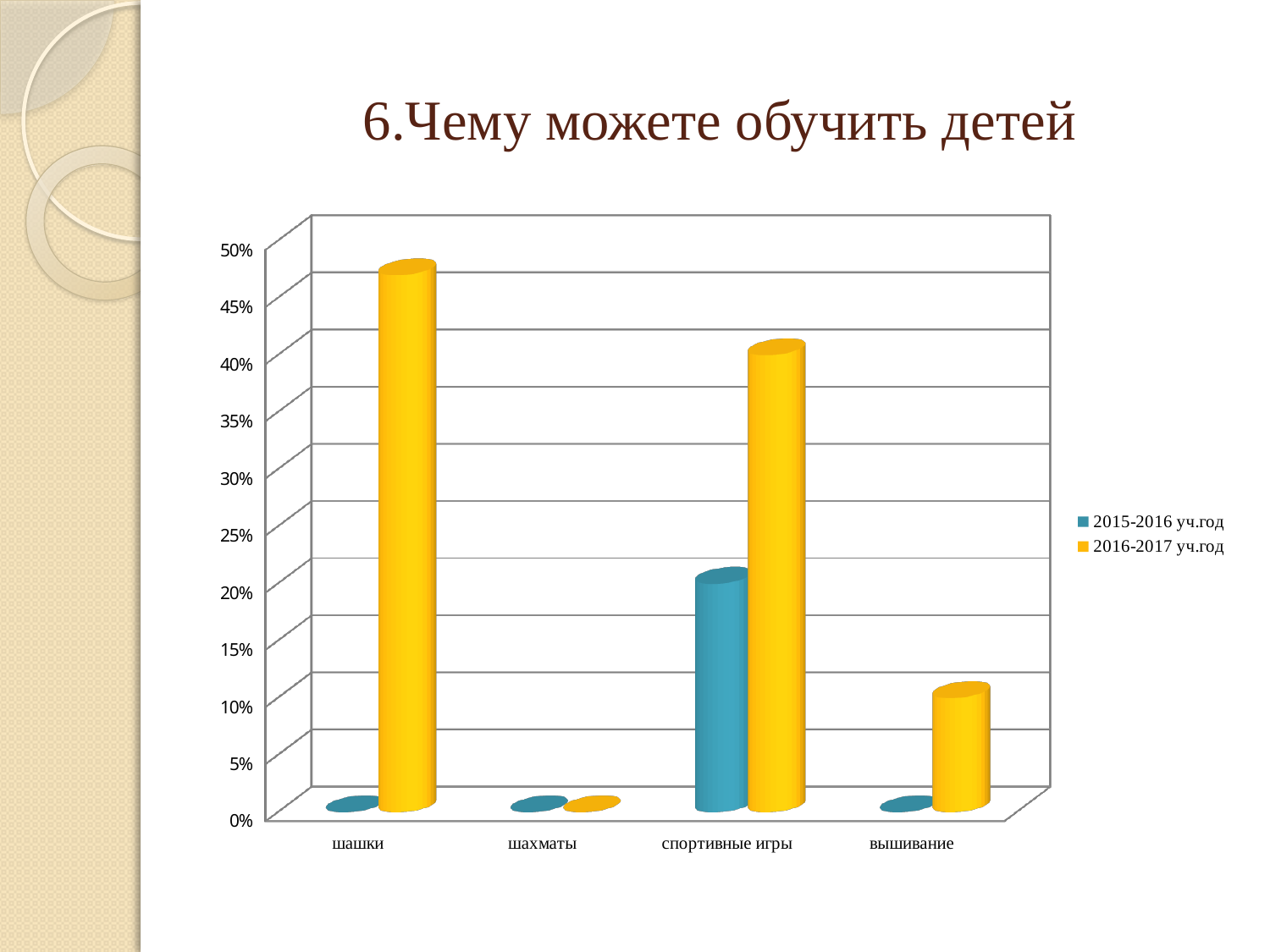
Is the value for спортивные игры in the 2015-2016 уч.год series greater or less than 25%? less How many series does the legend list? 2 For спортивные игры, which series has the larger value: 2015-2016 уч.год or 2016-2017 уч.год? 2016-2017 уч.год Is the value for спортивные игры in the 2016-2017 уч.год series greater or less than 35%? greater What is the title of the chart on the slide? 6.Чему можете обучить детей Which category has the highest value for the 2016-2017 уч.год series? шашки Which is larger: the 2016-2017 уч.год value for шашки or for вышивание? шашки How many categories are shown on the x axis? 4 Is the value for вышивание in the 2016-2017 уч.год series greater or less than 15%? less What kind of chart is shown on the slide? bar chart Which category has the highest value for the 2015-2016 уч.год series? спортивные игры